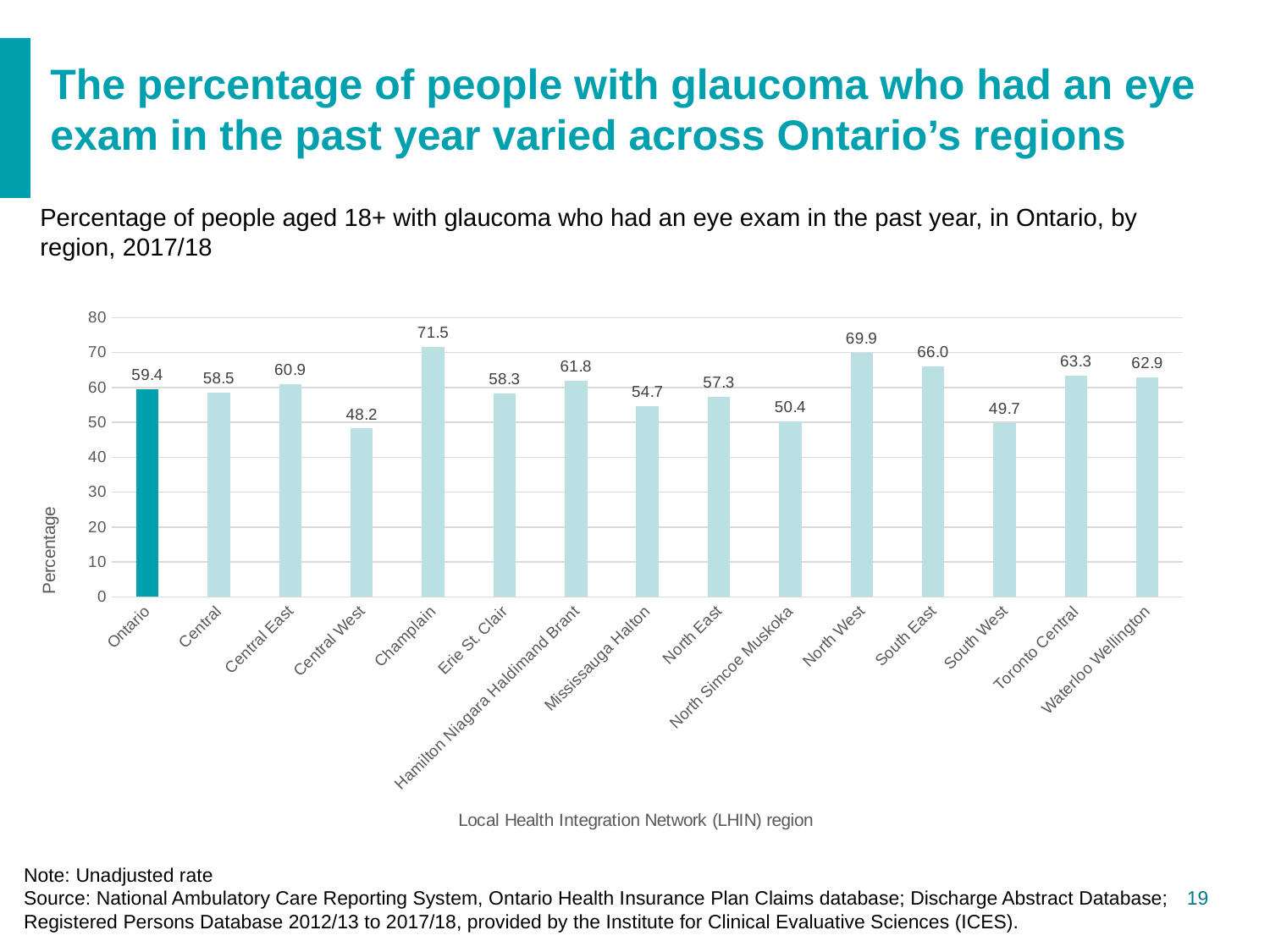
What is the label of the y axis? Percentage Which region has the highest value? Champlain What is the value for Champlain? 71.5 What is the value for North Simcoe Muskoka? 50.4 Which is larger, the value for Toronto Central or the value for Waterloo Wellington? Toronto Central What is the difference between the values for North West and South West? 20.2 What kind of chart is shown on the slide? Bar chart What is the value for Ontario? 59.4 Which region has the lowest value? Central West How many bars are shown in the chart? 15 Is the value for Hamilton Niagara Haldimand Brant greater or less than 60? greater Which bar is shown in a darker colour than the others? Ontario